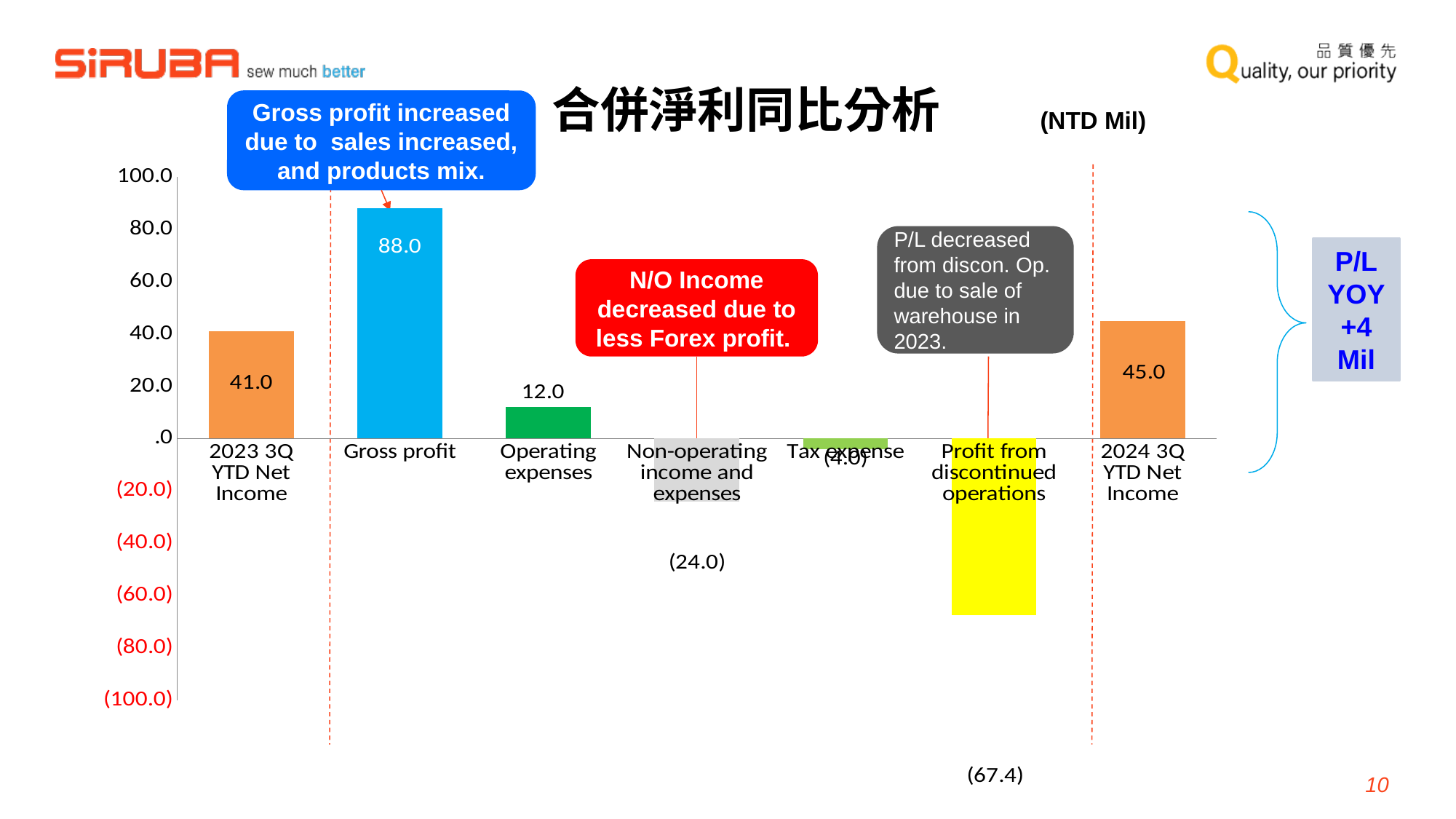
What is the value for Non-operating income and expenses? (24.0) What is the value for 2024 3Q YTD Net Income? 45.0 Which is larger, the value for Gross profit or the value for 2024 3Q YTD Net Income? Gross profit Which category has the lowest value? Profit from discontinued operations Which category has the highest value? Gross profit What is the difference between 2024 3Q YTD Net Income and 2023 3Q YTD Net Income? 4.0 What is the value for 2023 3Q YTD Net Income? 41.0 What is the value for Profit from discontinued operations? (67.4) How many categories are shown on the x axis? 7 What unit is stated for the chart values? NTD Mil What is the value for Operating expenses? 12.0 What is the value for Gross profit? 88.0